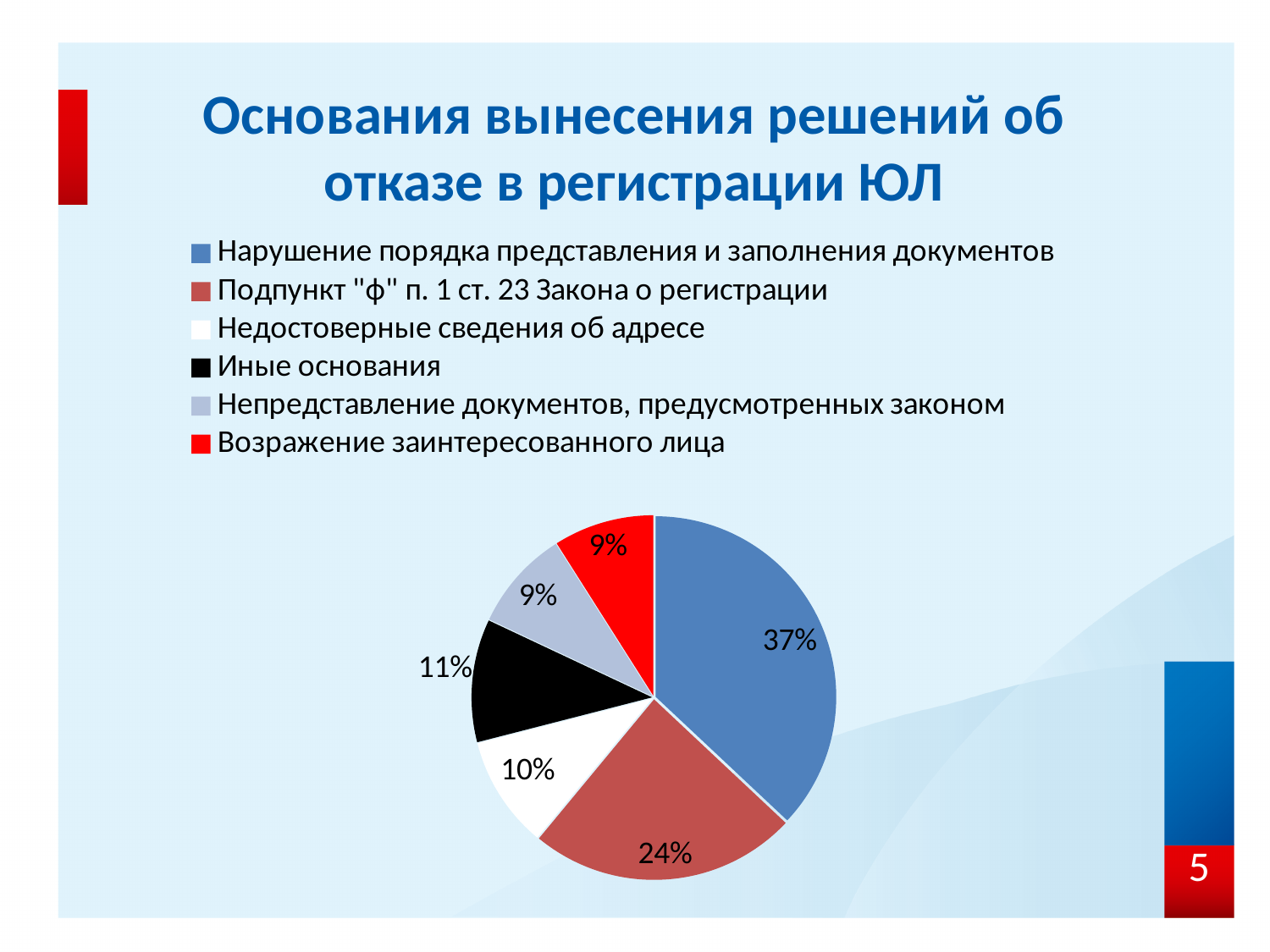
What is the title of the chart on the slide? Основания вынесения решений об отказе в регистрации ЮЛ What percentage is shown for "Иные основания"? 11% What percentage is shown for "Возражение заинтересованного лица"? 9% What type of chart is shown on the slide? pie chart What share of the pie is labelled for "Нарушение порядка представления и заполнения документов"? 37% Which category has the largest share of the pie? Нарушение порядка представления и заполнения документов What percentage is shown for "Недостоверные сведения об адресе"? 10% How many slices does the pie chart have? 6 Which is larger: the share for "Иные основания" or the share for "Недостоверные сведения об адресе"? Иные основания How many entries does the legend list? 6 What percentage is shown for "Подпункт "ф" п. 1 ст. 23 Закона о регистрации"? 24% What is the difference in percentage points between "Нарушение порядка представления и заполнения документов" and "Подпункт "ф" п. 1 ст. 23 Закона о регистрации"? 13 percentage points